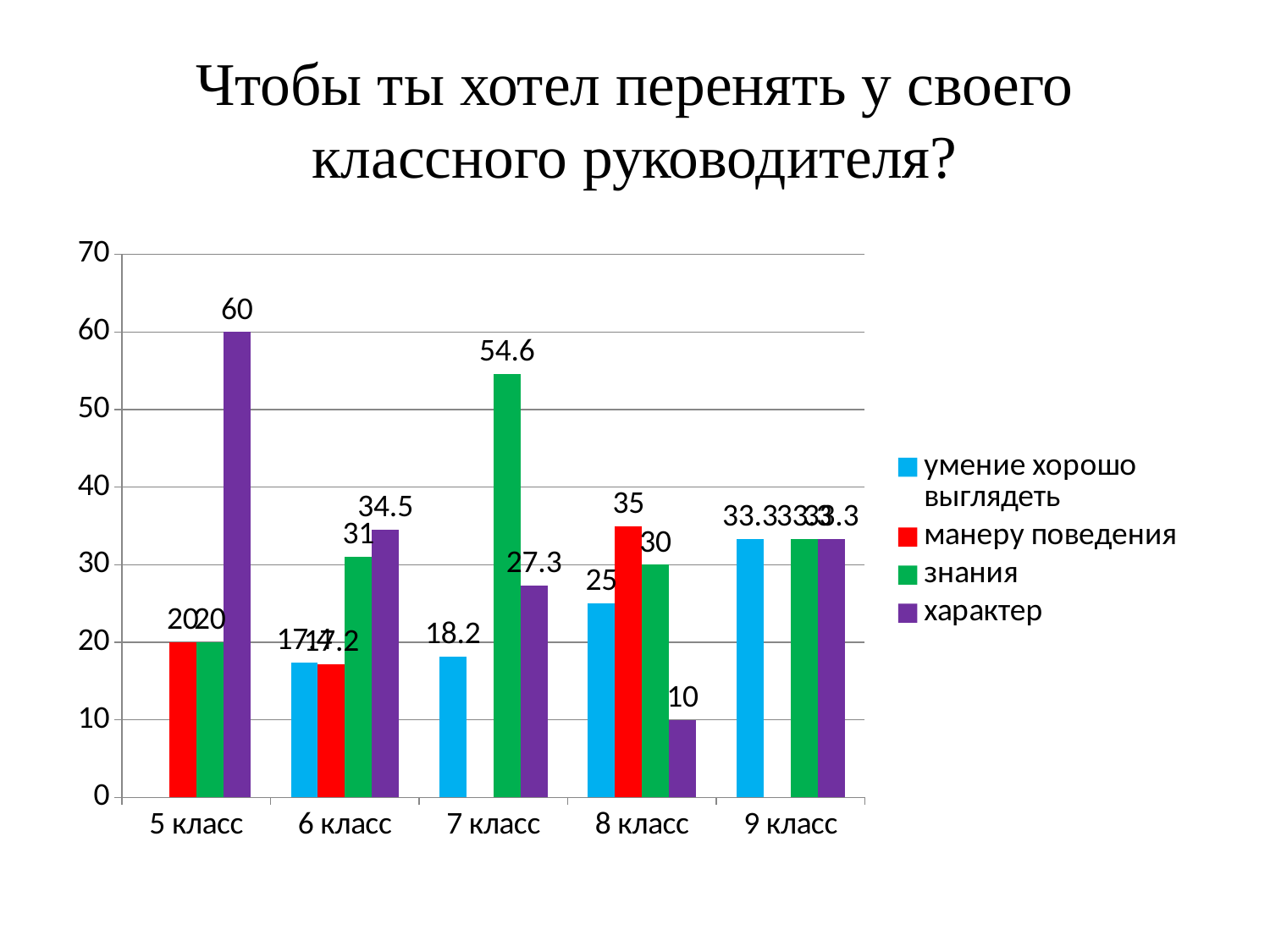
What is the value for характер in 7 класс? 27.3 Which class has the highest value for характер? 5 класс What is the value for характер in 5 класс? 60 What is the value for знания in 7 класс? 54.6 What is the value for манеру поведения in 8 класс? 35 Which series has the lowest value in 8 класс? характер How many series does the legend list? 4 In 8 класс, what is the difference between манеру поведения and характер? 25 How many classes (categories) are shown on the x axis? 5 What kind of chart is shown on the slide? bar chart Is the value for умение хорошо выглядеть in 9 класс greater or less than 30? greater In 6 класс, which is larger: знания or характер? характер